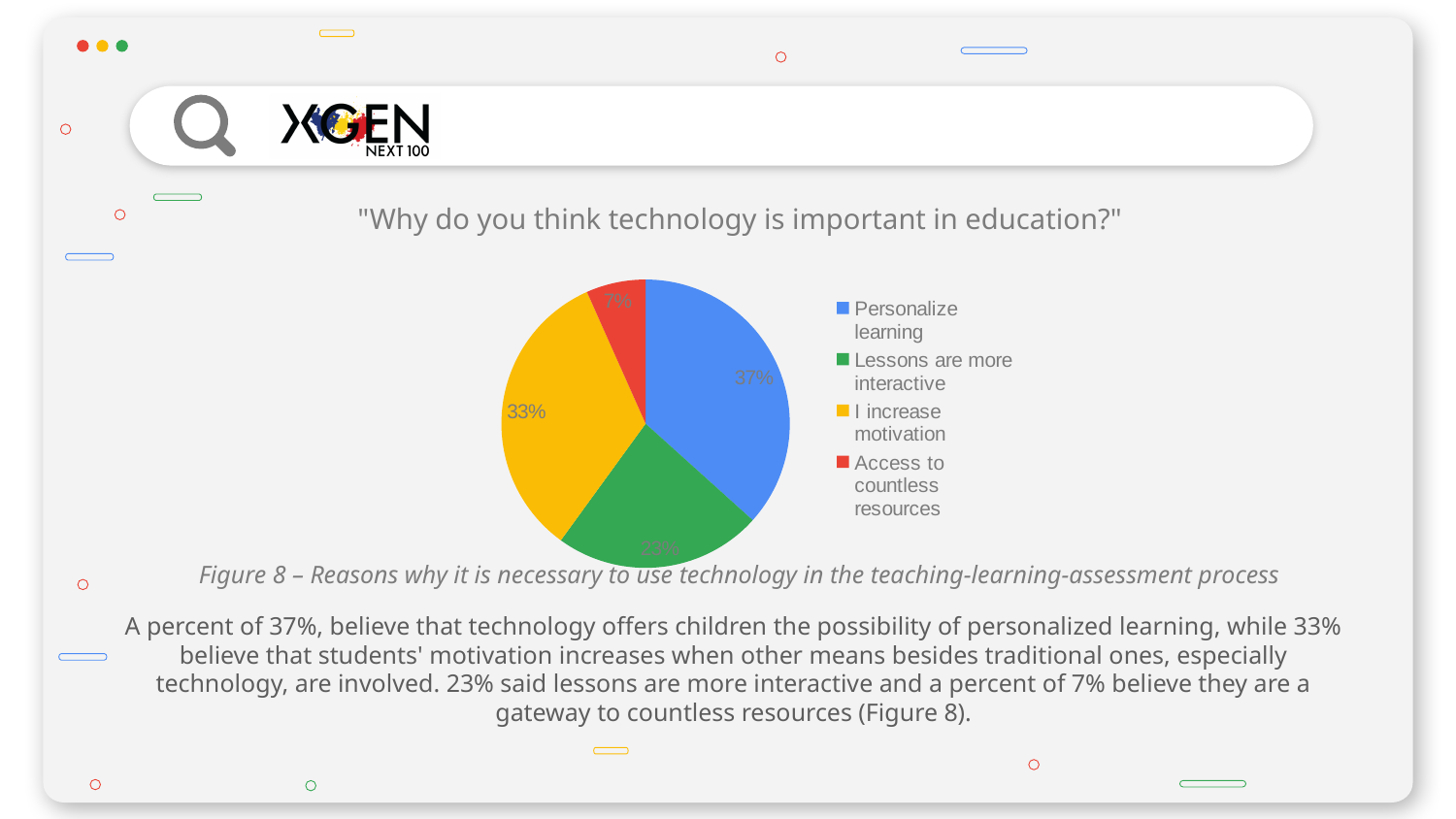
What kind of chart is shown on the slide? pie chart What share of the pie is labelled for "Access to countless resources"? 7% Which category has the largest slice of the pie? Personalize learning What share of the pie is labelled for "Lessons are more interactive"? 23% What share of the pie is labelled for "I increase motivation"? 33% Which category has the smallest slice of the pie? Access to countless resources What colour is the slice for "Lessons are more interactive"? green How many categories does the pie chart have? 4 What share of the pie is labelled for "Personalize learning"? 37% What is the title shown above the pie chart? "Why do you think technology is important in education?" What is the difference in percentage points between "Personalize learning" and "I increase motivation"? 4 Which is larger, the slice for "Lessons are more interactive" or the slice for "I increase motivation"? I increase motivation